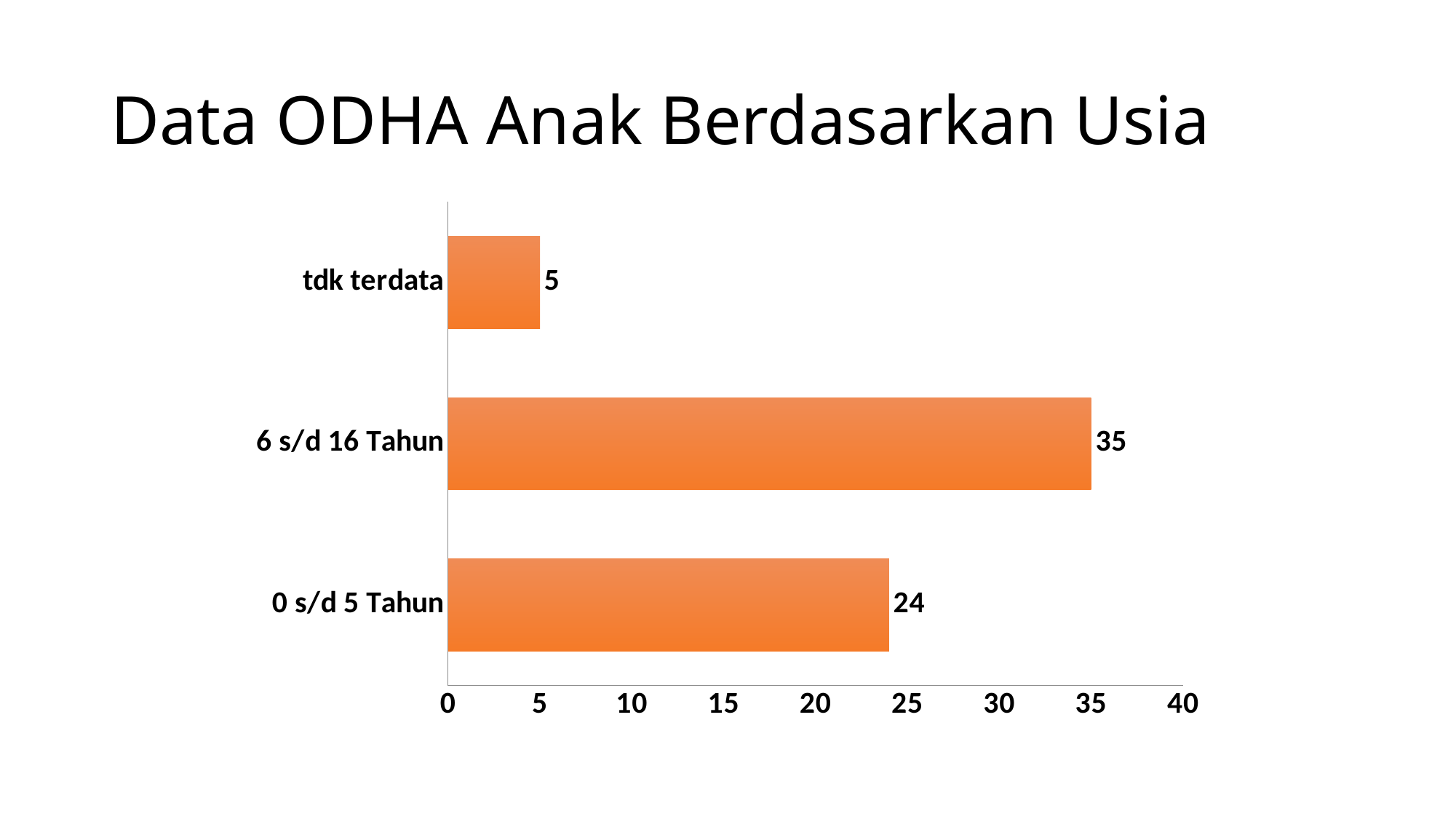
What is the value for 6 s/d 16 Tahun? 35 How many categories are shown in the chart? 3 What is the value for tdk terdata? 5 Which category has the lowest value? tdk terdata What is the value for 0 s/d 5 Tahun? 24 What is the difference between the values for 0 s/d 5 Tahun and tdk terdata? 19 Which is larger, the value for 0 s/d 5 Tahun or the value for tdk terdata? 0 s/d 5 Tahun Is the value for 0 s/d 5 Tahun greater or less than 20? greater Which category has the highest value? 6 s/d 16 Tahun What is the title of the slide? Data ODHA Anak Berdasarkan Usia What kind of chart is shown on the slide? bar chart What is the difference between the values for 6 s/d 16 Tahun and 0 s/d 5 Tahun? 11